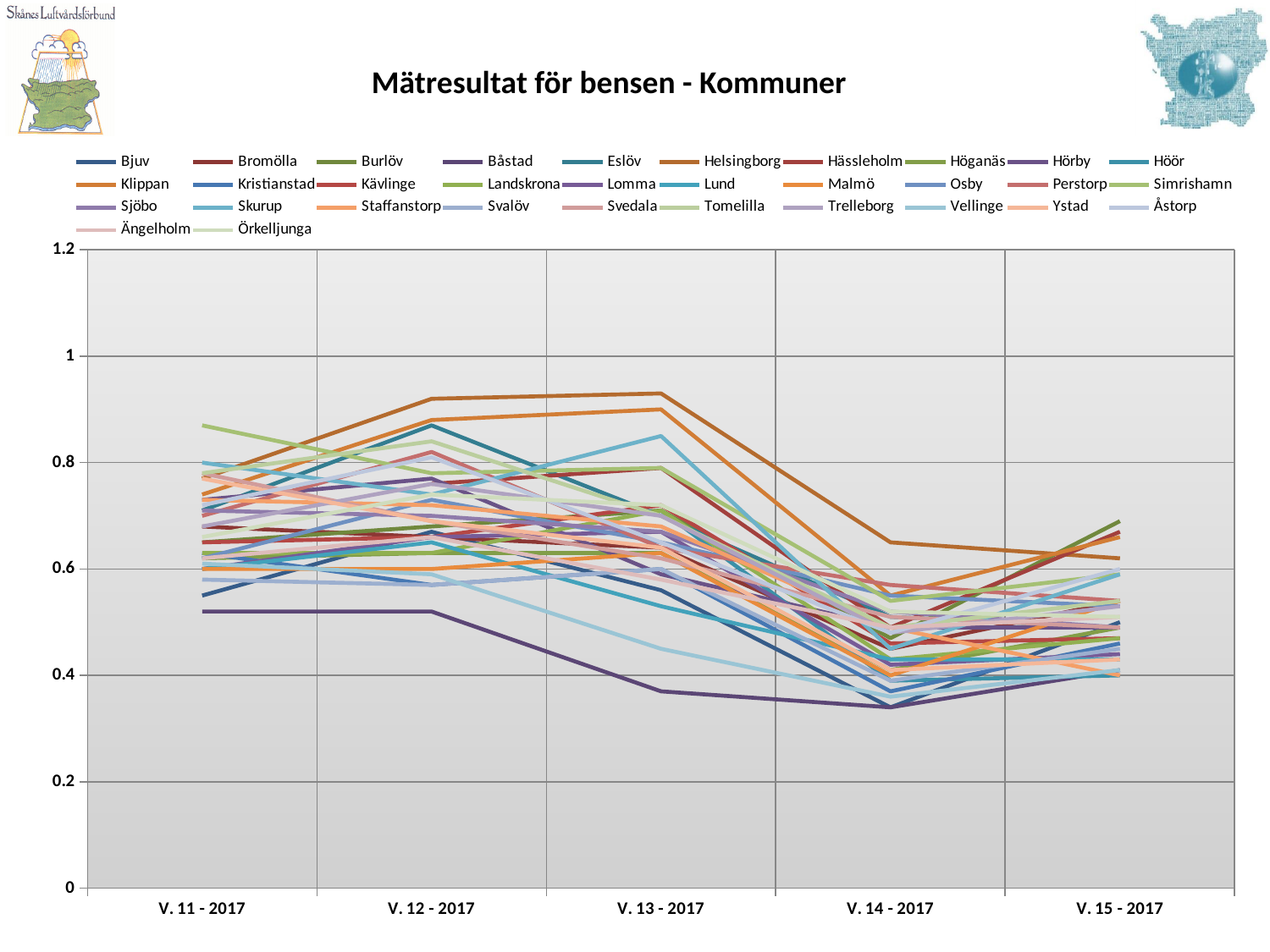
What is the first category on the x axis? V. 11 - 2017 Is the lowest value plotted at V. 14 - 2017 greater or less than 0.4? less What kind of chart is shown on the slide? line chart Do the values for most municipalities rise or fall from V. 13 - 2017 to V. 14 - 2017? fall Is the highest value plotted at V. 13 - 2017 greater or less than 0.8? greater What is the title of the chart? Mätresultat för bensen - Kommuner How many series (municipalities) does the legend list? 32 Is the highest value plotted at V. 15 - 2017 greater or less than 0.8? less How many weeks (categories) are shown on the x axis? 5 What is the maximum value shown on the y axis? 1.2 What is the last category on the x axis? V. 15 - 2017